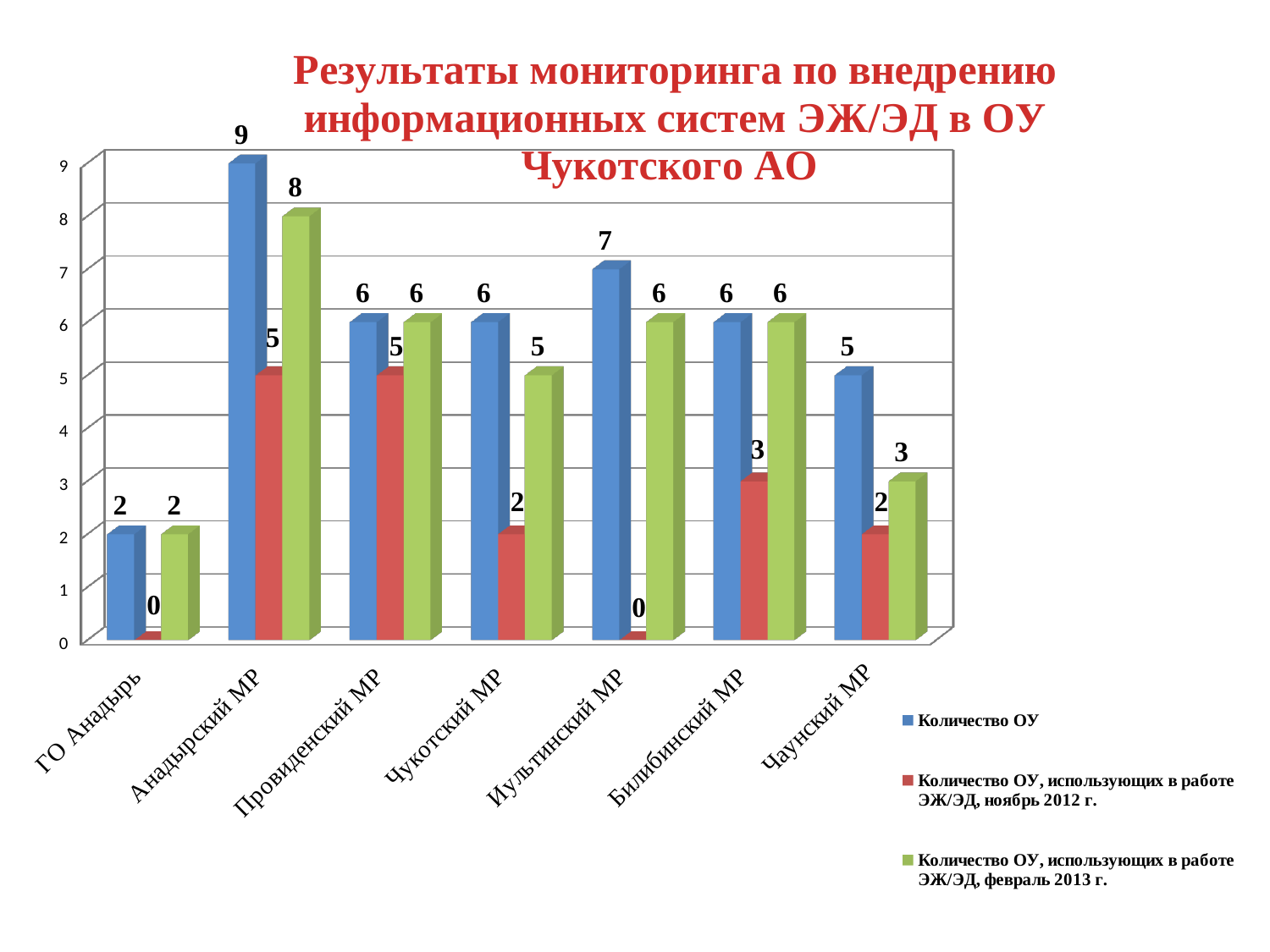
Which category has the lowest value of "Количество ОУ"? ГО Анадырь What is the value for Чаунский МР in the series "Количество ОУ, использующих в работе ЭЖ/ЭД, февраль 2013 г."? 3 How many categories (districts) are shown on the x axis? 7 What type of chart is shown on the slide? bar chart Which category has the highest value in the series "Количество ОУ, использующих в работе ЭЖ/ЭД, февраль 2013 г."? Анадырский МР For Чукотский МР, which is larger: the November 2012 value or the February 2013 value? February 2013 How many series does the legend list? 3 What is the value for Иультинский МР in the series "Количество ОУ, использующих в работе ЭЖ/ЭД, ноябрь 2012 г."? 0 What is the difference between "Количество ОУ" and the February 2013 value for Чаунский МР? 2 Which colour represents the series "Количество ОУ, использующих в работе ЭЖ/ЭД, ноябрь 2012 г."? red What is the value of "Количество ОУ" for Анадырский МР? 9 What is the difference between the February 2013 value and the November 2012 value for Иультинский МР? 6